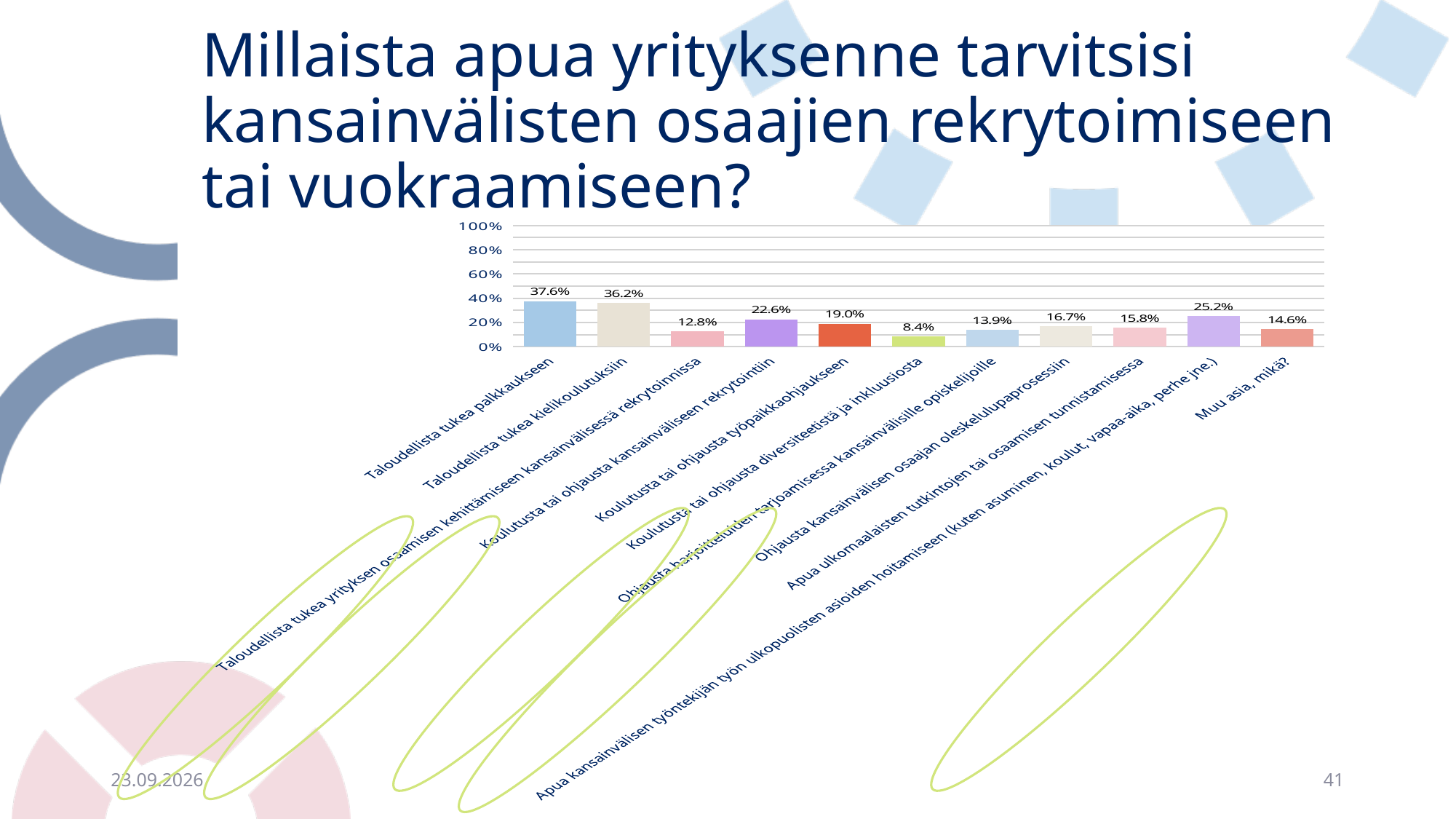
Which category has the highest value? Taloudellista tukea palkkaukseen How many categories (bars) does the chart show? 11 Is the value for "Apua ulkomaalaisten tutkintojen tai osaamisen tunnistamisessa" greater or less than 20%? less What is the difference between the values for "Taloudellista tukea palkkaukseen" and "Taloudellista tukea kielikoulutuksiin"? 1.4% Which category has the lowest value? Koulutusta tai ohjausta diversiteetistä ja inkluusiosta What kind of chart is shown on the slide? bar chart What is the value for "Muu asia, mikä?"? 14.6% What is the value for "Taloudellista tukea palkkaukseen"? 37.6% What is the value for "Koulutusta tai ohjausta kansainväliseen rekrytointiin"? 22.6% What is the value for "Taloudellista tukea kielikoulutuksiin"? 36.2% What is the highest value shown on the vertical axis? 100% Which is larger: the value for "Koulutusta tai ohjausta työpaikkaohjaukseen" or the value for "Ohjausta kansainvälisen osaajan oleskelulupaprosessiin"? Koulutusta tai ohjausta työpaikkaohjaukseen